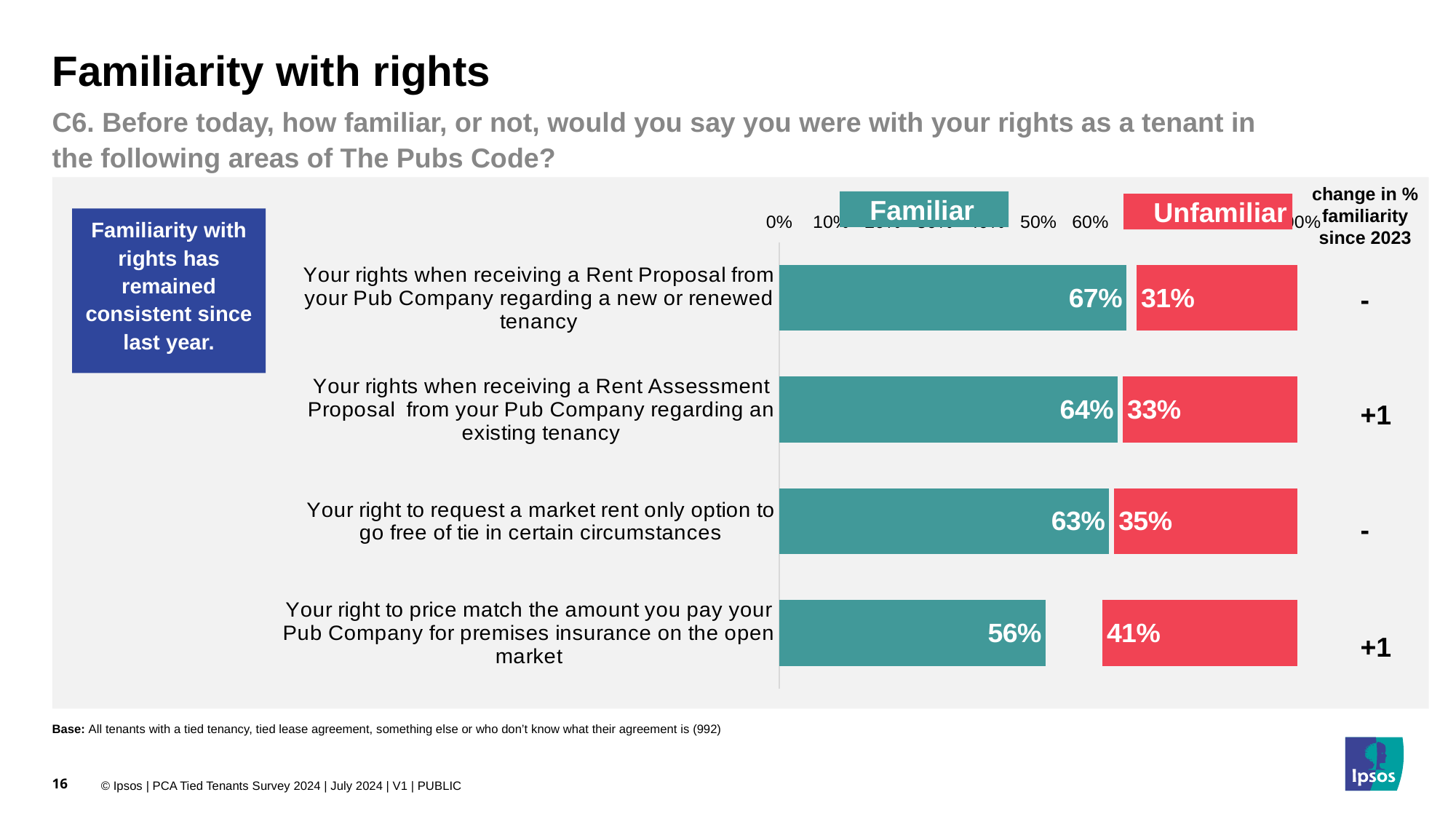
Which area of The Pubs Code has the highest share of tenants who were familiar with their rights? Your rights when receiving a Rent Proposal from your Pub Company regarding a new or renewed tenancy How many series does the chart legend list? 2 Which area of The Pubs Code has the lowest share of tenants who were familiar with their rights? Your right to price match the amount you pay your Pub Company for premises insurance on the open market What kind of chart is used on this slide? Stacked horizontal bar chart What percentage of tenants were unfamiliar with their right to price match the amount they pay their Pub Company for premises insurance on the open market? 41% Which is larger: the Unfamiliar percentage for the Rent Proposal (new or renewed tenancy) or the Unfamiliar percentage for the premises insurance price match right? Premises insurance price match right (41%) What percentage of tenants were unfamiliar with their rights when receiving a Rent Assessment Proposal regarding an existing tenancy? 33% How many areas of The Pubs Code are shown as categories in the chart? 4 What percentage of tenants were familiar with their rights when receiving a Rent Proposal from their Pub Company regarding a new or renewed tenancy? 67% What is the combined Familiar and Unfamiliar percentage for the rights when receiving a Rent Assessment Proposal regarding an existing tenancy? 97% What is the change in % familiarity since 2023 shown for the right to price match premises insurance on the open market? +1 What is the difference between the Familiar and Unfamiliar percentages for the right to request a market rent only option to go free of tie? 28 percentage points